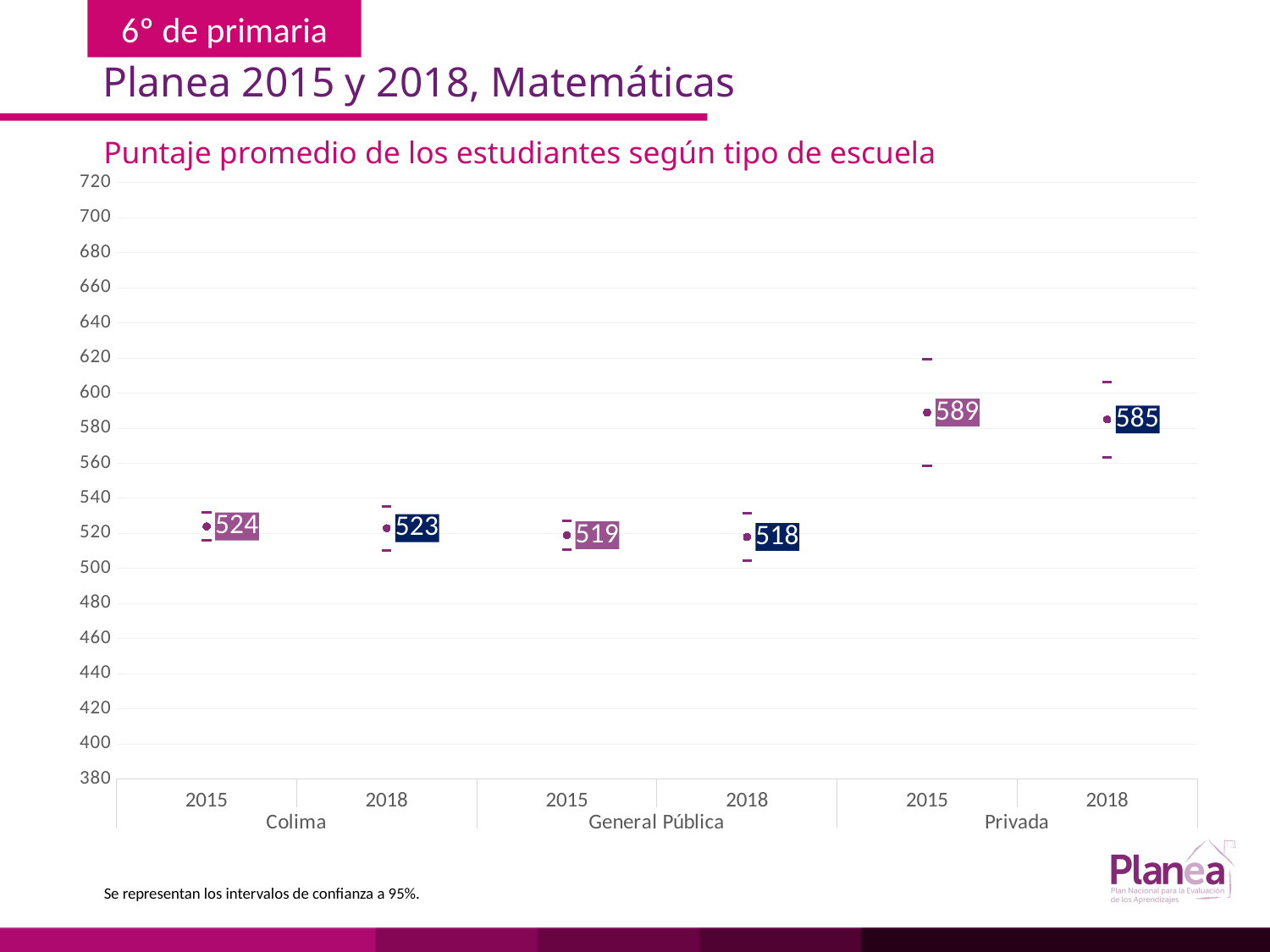
Did the Colima average score rise or fall from 2015 to 2018? fall What is the difference between the Privada score in 2015 and the Privada score in 2018? 4 Which school type and year has the lowest average score? General Pública, 2018 What is the average score for Colima in 2015? 524 Which school type and year has the highest average score? Privada, 2015 What is the title of the chart? Puntaje promedio de los estudiantes según tipo de escuela What is the difference between the Colima score in 2015 and the General Pública score in 2015? 5 Which is larger, the Privada score in 2018 or the Colima score in 2018? Privada 2018 What is the average score for Privada schools in 2018? 585 Is the Privada score in 2015 greater or less than 560? greater What is the average score for General Pública in 2015? 519